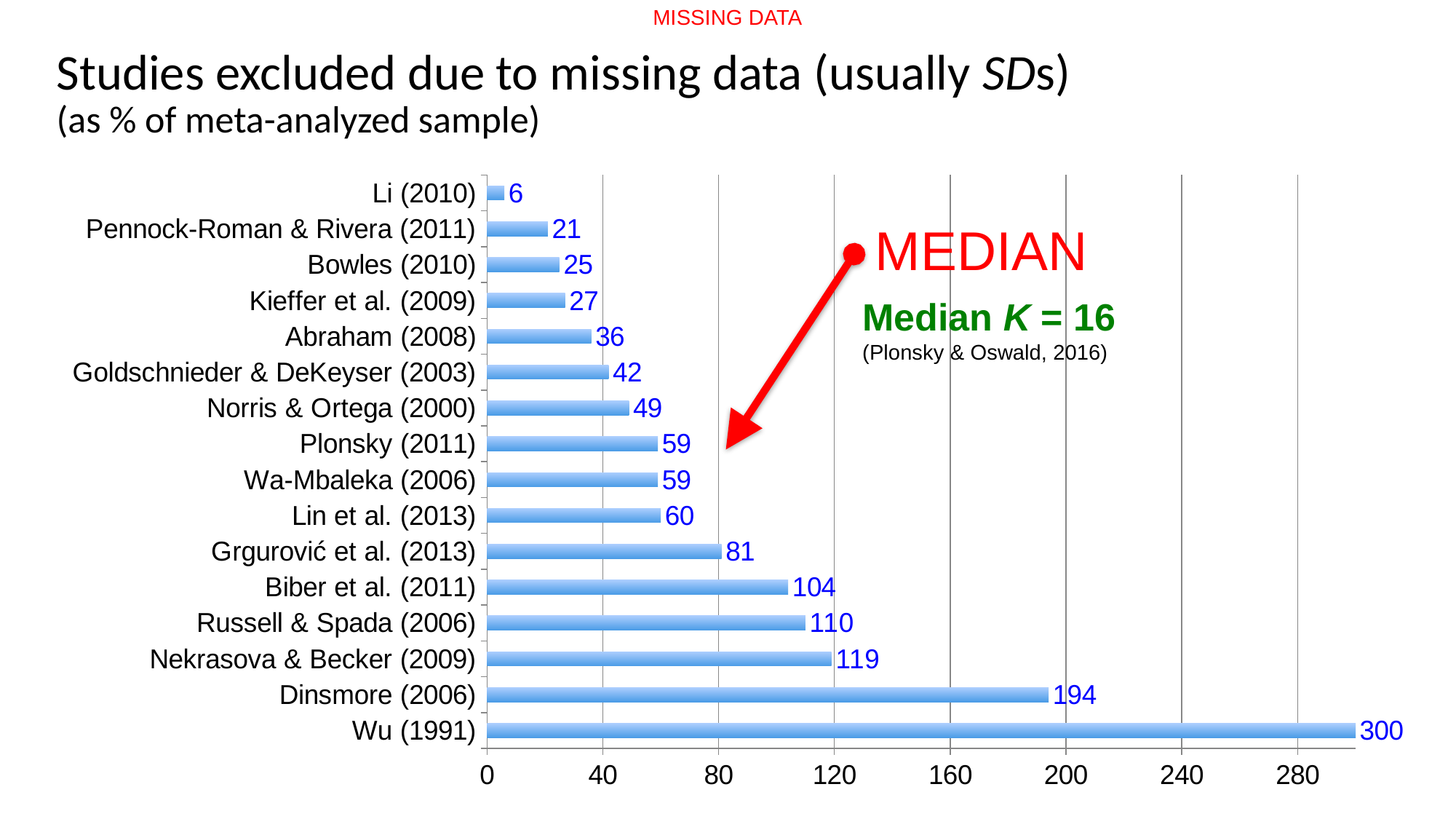
Which study has the lowest value? Li (2010) Which is larger, the value for Grgurović et al. (2013) or the value for Lin et al. (2013)? Grgurović et al. (2013) What is the value for Norris & Ortega (2000)? 49 Which study has the highest value? Wu (1991) Which study is marked as the median by the red arrow? Plonsky (2011) What kind of chart is shown on the slide? bar chart What is the value for Abraham (2008)? 36 Is the value for Russell & Spada (2006) greater or less than 80? greater How many studies are shown in the chart? 16 What is the value for Biber et al. (2011)? 104 What is the difference between the values for Dinsmore (2006) and Nekrasova & Becker (2009)? 75 What is the value for Wu (1991)? 300